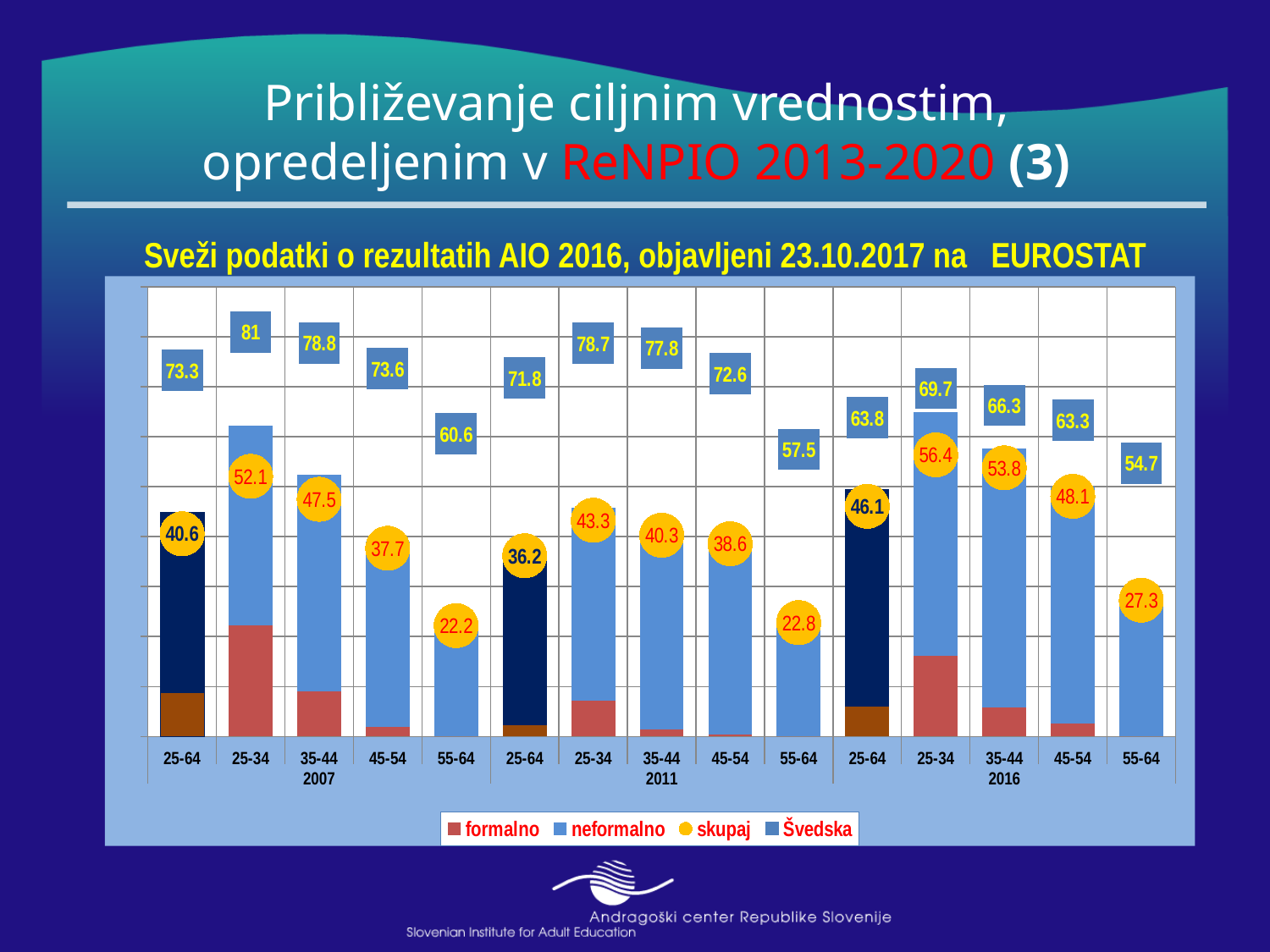
What is the 'Švedska' value for the 25-34 age group in 2007? 81 What is the 'skupaj' value for the 25-34 age group in 2016? 56.4 What kind of chart is shown on the slide? Stacked bar chart How many entries does the legend list? 4 What is the difference between the 'Švedska' value and the 'skupaj' value for the 25-64 age group in 2016? 17.7 Is the 'skupaj' value for 25-64 higher in 2007 or in 2011? 2007 Which age group and year has the lowest 'skupaj' value? 55-64 in 2007 (22.2) What is the 'skupaj' value for the 55-64 age group in 2011? 22.8 Does the 'Švedska' value for the 25-64 age group rise or fall from 2007 to 2016? Fall How many stacked bars are plotted in the chart? 15 Which age group and year has the lowest 'Švedska' value? 55-64 in 2016 (54.7) Which age group and year has the highest 'skupaj' value? 25-34 in 2016 (56.4)